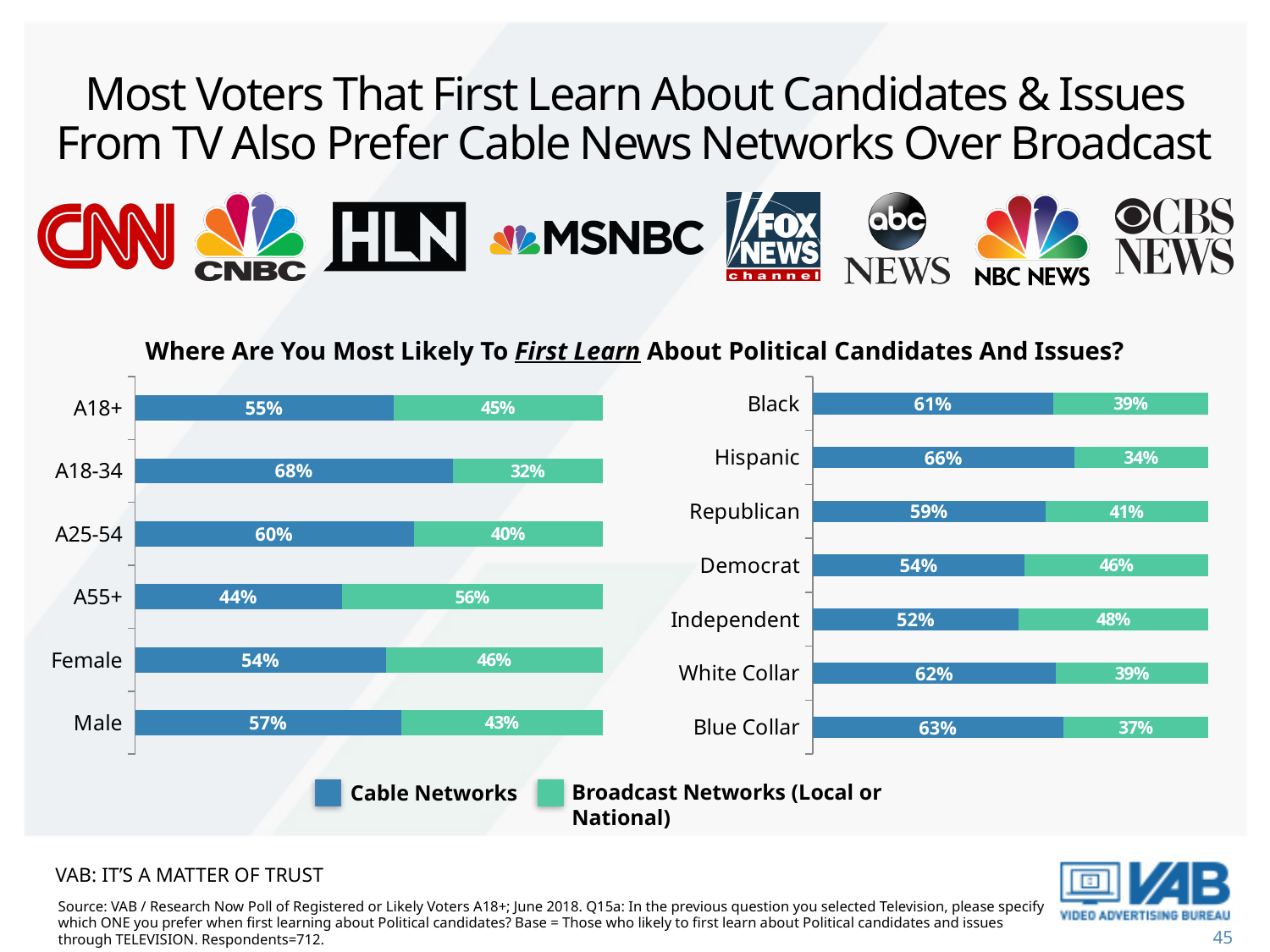
In the left chart, what is the difference between the Cable Networks values for A18-34 and A55+? 24% In the left chart, what percentage of A18-34 voters prefer Cable Networks? 68% What kind of chart is the left chart? Stacked bar chart What is the question shown as the title above the charts? Where Are You Most Likely To First Learn About Political Candidates And Issues? In the left chart, what is the total of the stacked bar for Female? 100% In the right chart, what percentage of Hispanic voters prefer Broadcast Networks (Local or National)? 34% How many series does the legend list? 2 In the right chart, which is larger: the Cable Networks value for Republican or for Democrat? Republican In the left chart, which category has the highest Cable Networks value? A18-34 How many categories are shown in the right chart? 7 In the right chart, which category has the lowest Cable Networks value? Independent How many categories are shown in the left chart? 6